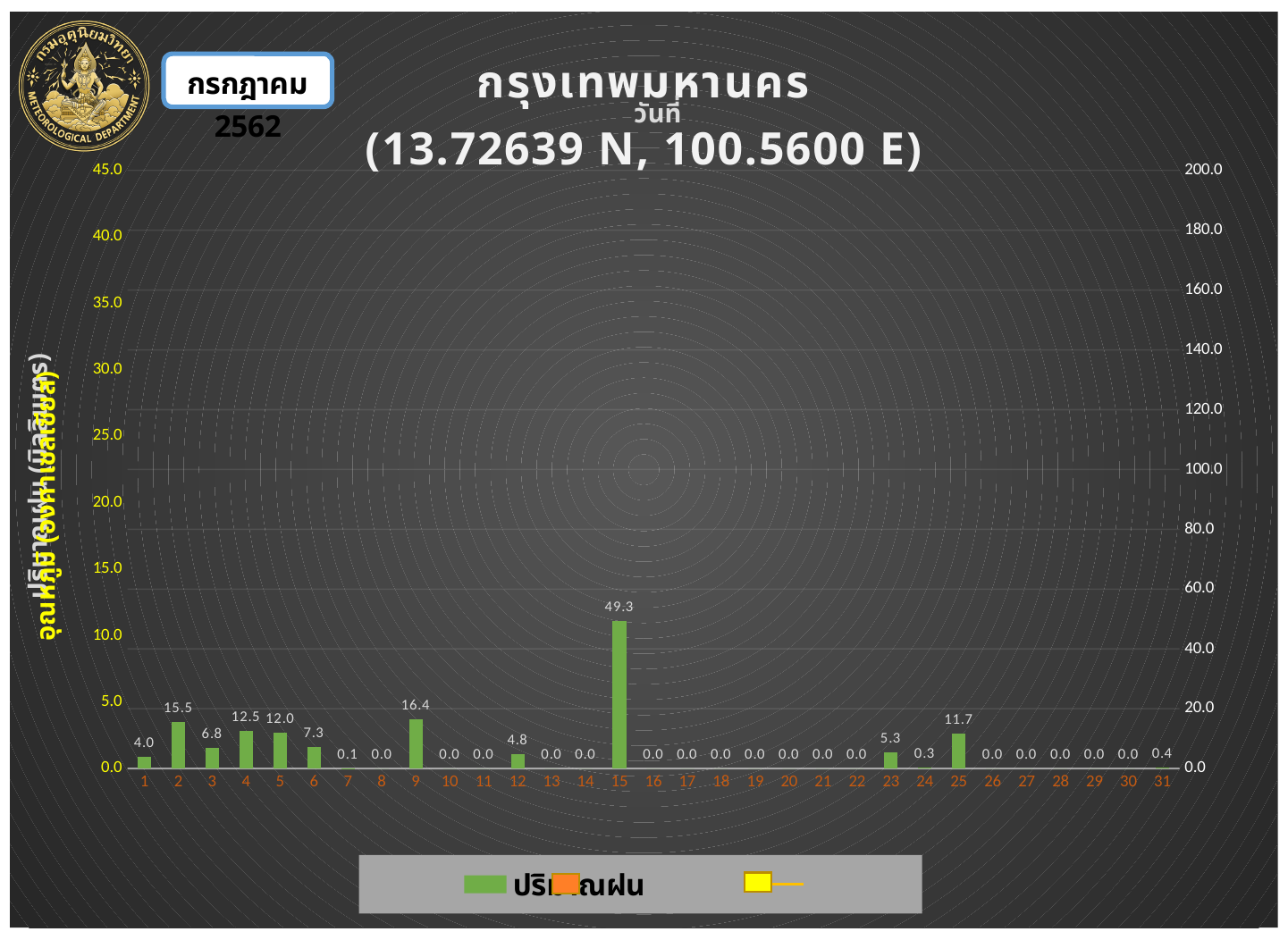
What is the difference between the rainfall values for day 15 and day 9? 32.9 What is the rainfall value for day 9? 16.4 What is the rainfall value for day 2? 15.5 What coordinates are given in the chart title? 13.72639 N, 100.5600 E What is the difference between the rainfall values for day 4 and day 5? 0.5 What is the rainfall value for day 15? 49.3 What is the rainfall value for day 31? 0.4 What kind of chart is shown on the slide? bar chart How many days are shown on the x axis? 31 Which has a larger rainfall value, day 2 or day 6? day 2 What is the rainfall value for day 25? 11.7 Which day has the highest rainfall value? 15